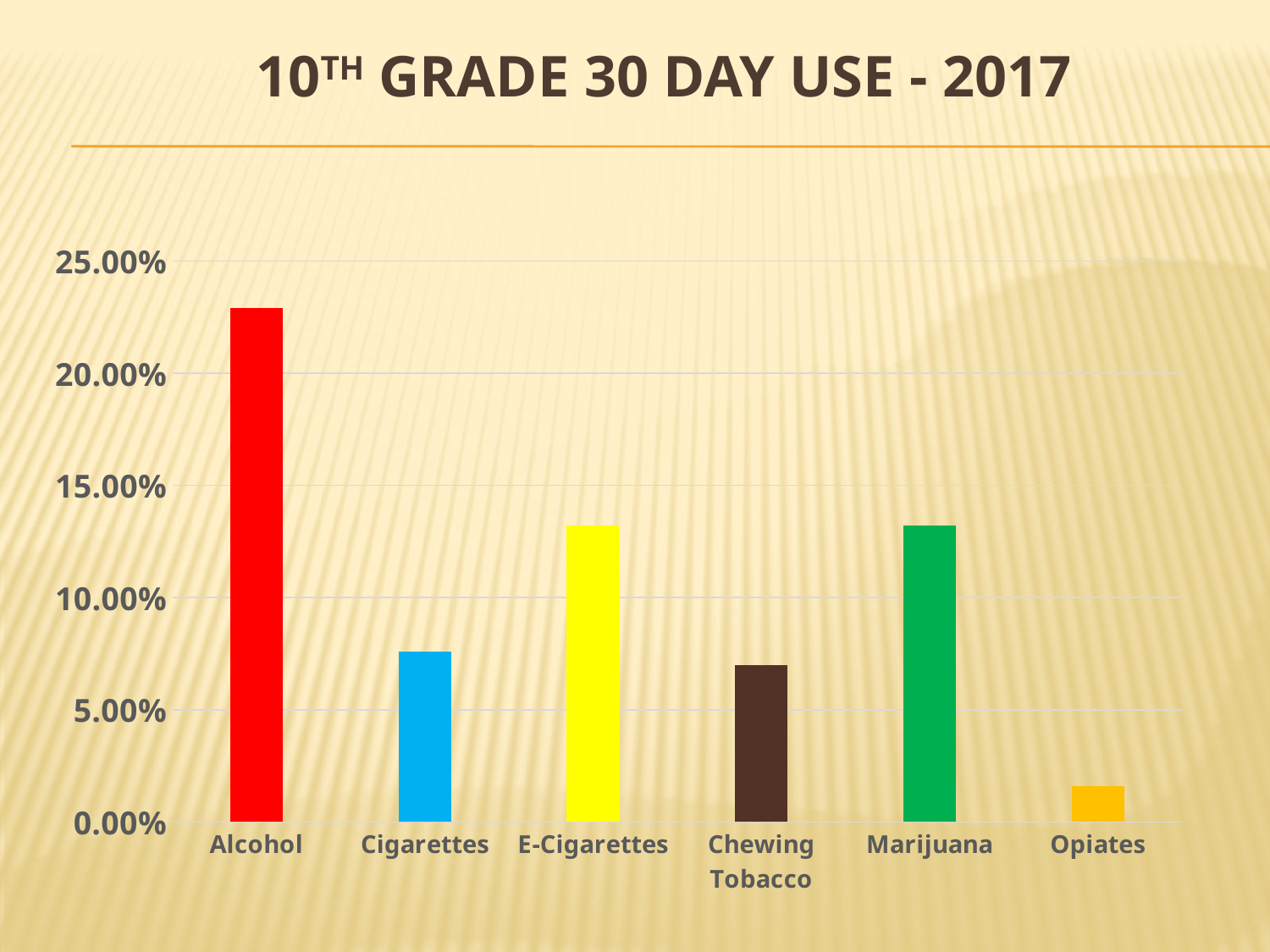
Which category has the lowest value? Opiates Is the value for Opiates greater or less than 5.00%? less How many categories are shown on the x axis? 6 Is the value for Chewing Tobacco greater or less than 10.00%? less Is the value for Cigarettes greater or less than 5.00%? greater What kind of chart is shown on the slide? bar chart What colour is the bar for Alcohol? red Which category has the highest value? Alcohol Which is larger, the value for Alcohol or the value for Marijuana? Alcohol What is the title of the chart? 10th Grade 30 Day Use - 2017